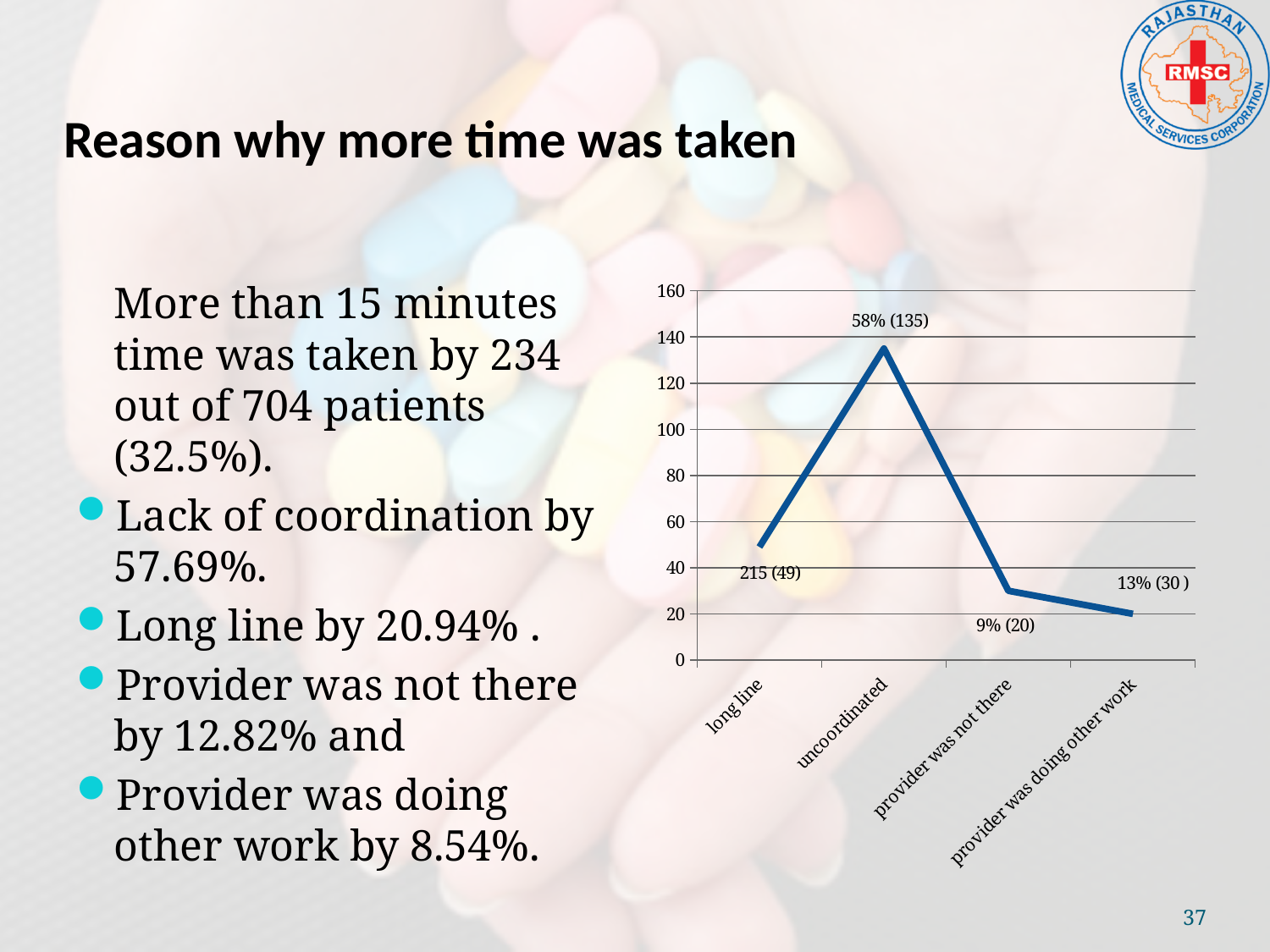
How many categories are plotted on the x axis of the chart? 4 Which is larger, the value for 'long line' or the value for 'provider was doing other work'? long line What is the data label shown for the 'long line' point? 215 (49) Which category has the highest value on the chart? uncoordinated Is the value for 'long line' greater or less than 60? less Which category has the lowest value on the chart? provider was doing other work What is the data label shown for the 'provider was doing other work' point? 13% (30 ) What is the highest tick value shown on the y axis of the chart? 160 What is the data label shown for the 'uncoordinated' point? 58% (135) What kind of chart is shown on the slide? line chart Is the value for 'uncoordinated' greater or less than 120? greater What is the data label shown for the 'provider was not there' point? 9% (20)